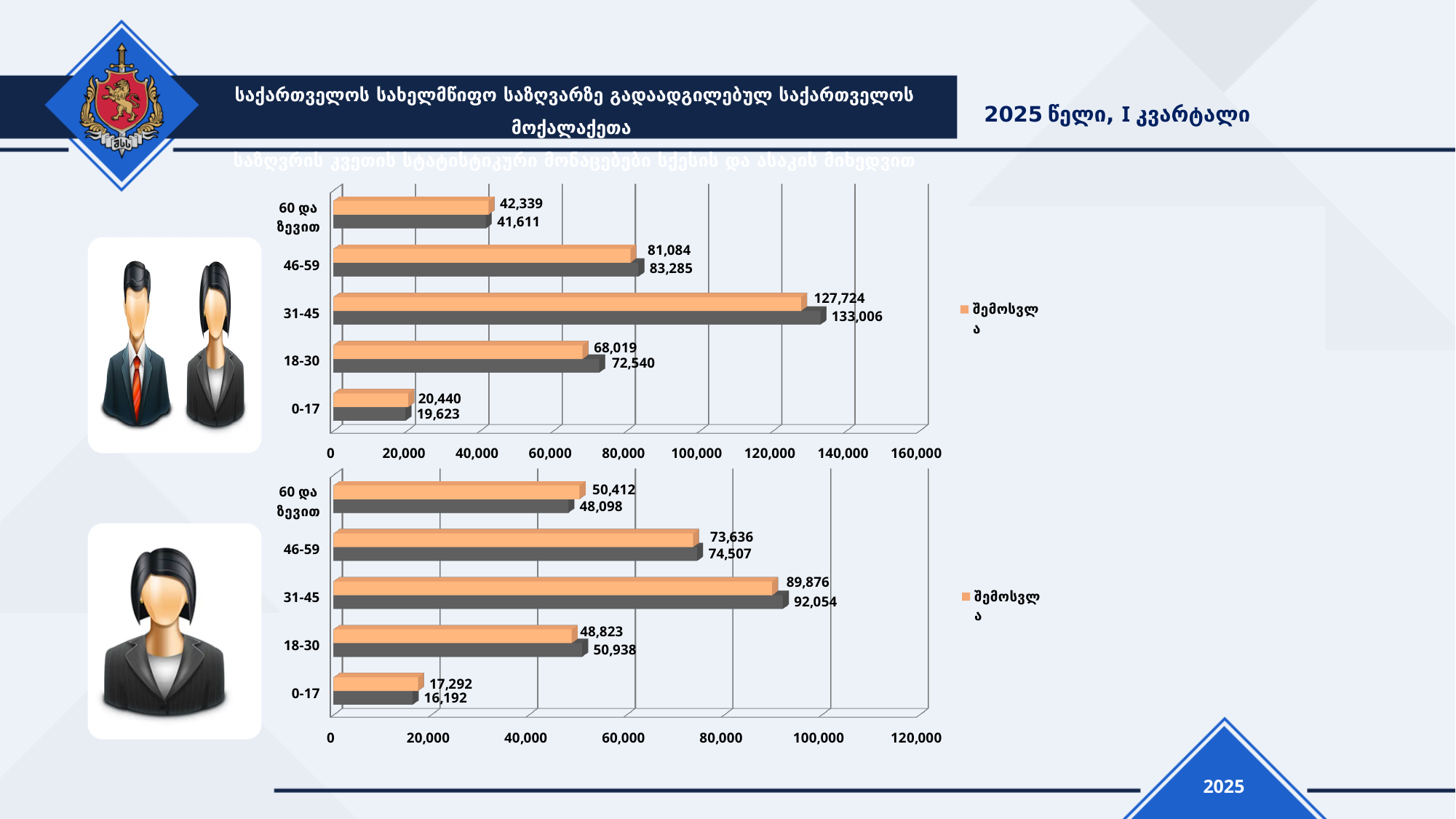
In the top chart, which age group has the highest შემოსვლა (orange) value? 31-45 Is the შემოსვლა (orange) value for the 46-59 age group in the top chart greater or less than 100,000? less What legend entry is shown next to the top chart? შემოსვლა In the bottom chart, for the 60 და ზევით age group, which bar is larger: the orange (შემოსვლა) bar or the dark gray bar? the orange (შემოსვლა) bar In the bottom chart, what is the value of the dark gray bar for the 18-30 age group? 50,938 In the top chart, what is the შემოსვლა (orange) value for the 31-45 age group? 127,724 How many age groups are shown on the y axis of the top chart? 5 What type of chart is the bottom chart? bar chart In the top chart, what is the value of the dark gray bar for the 0-17 age group? 19,623 In the bottom chart, which age group has the lowest შემოსვლა (orange) value? 0-17 In the bottom chart, what is the difference between the orange bar and the dark gray bar for the 0-17 age group? 1,100 In the top chart, what is the difference between the dark gray bar (133,006) and the orange bar (127,724) for the 31-45 age group? 5,282